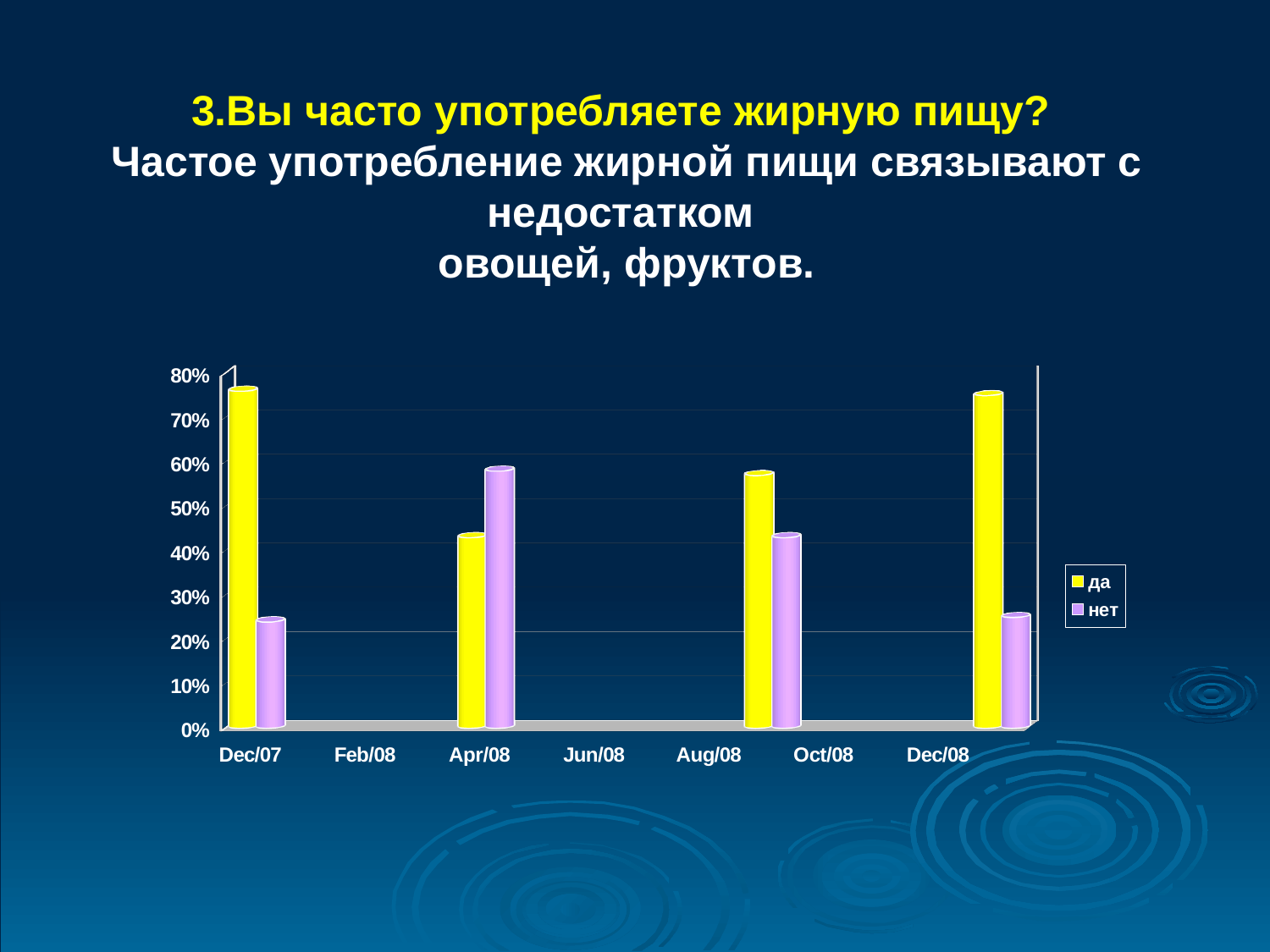
Is the value for "да" at Dec/07 greater or less than 70%? greater How many series does the legend list? 2 What are the two entries in the chart's legend? да, нет At Apr/08, which series has the larger value, "да" or "нет"? нет What kind of chart is shown on the slide? bar chart Is the value for "да" at Aug/08 greater or less than 50%? greater What colour are the bars for the series "да"? yellow Is the value for "нет" at Apr/08 greater or less than 50%? greater At which date is the "нет" bar the highest? Apr/08 How many groups of bars are plotted on the chart? 4